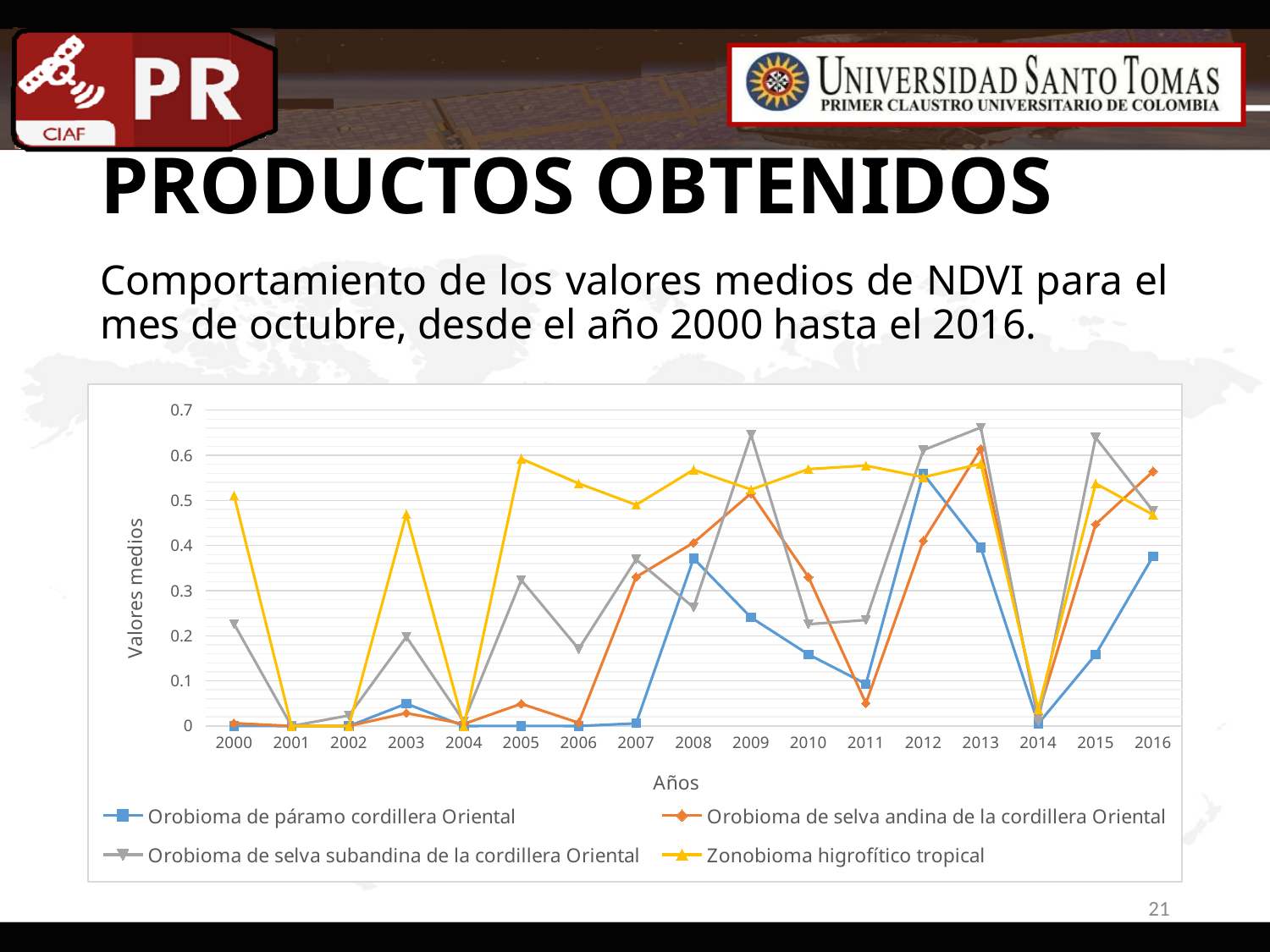
How many years are plotted along the x axis? 17 Is the value for Zonobioma higrofítico tropical in 2005 greater or less than 0.5? greater What kind of chart is shown on the slide? line chart Is the value for Orobioma de páramo cordillera Oriental in 2012 greater or less than 0.5? greater In 2016, which is larger: Orobioma de selva andina de la cordillera Oriental or Orobioma de páramo cordillera Oriental? Orobioma de selva andina de la cordillera Oriental How many series does the legend list? 4 In 2010, which is larger: Zonobioma higrofítico tropical or Orobioma de páramo cordillera Oriental? Zonobioma higrofítico tropical Is the value for Orobioma de selva subandina de la cordillera Oriental in 2009 greater or less than 0.6? greater Which series has the highest value in 2013? Orobioma de selva subandina de la cordillera Oriental Which series has the lowest value in 2010? Orobioma de páramo cordillera Oriental Does the value for Orobioma de páramo cordillera Oriental rise or fall from 2012 to 2014? fall